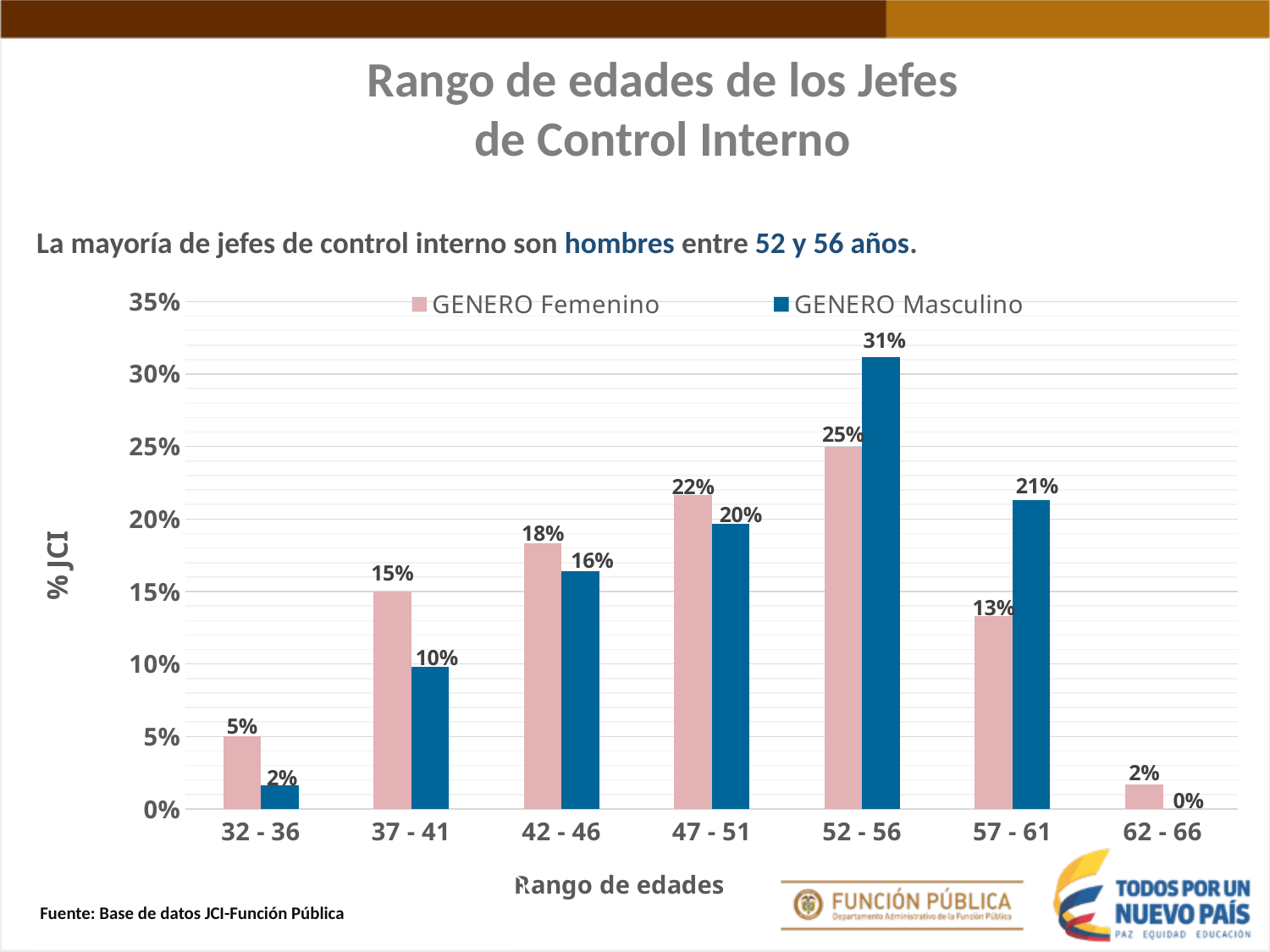
Which is larger in the 47 - 51 age range, GENERO Femenino or GENERO Masculino? GENERO Femenino What is the value for GENERO Masculino in the 62 - 66 age range? 0% What is the value for GENERO Femenino in the 37 - 41 age range? 15% Which age range has the highest value for GENERO Femenino? 52 - 56 How many age ranges are shown on the x axis? 7 What is the title of the chart on the slide? Rango de edades de los Jefes de Control Interno What is the difference between GENERO Masculino and GENERO Femenino in the 57 - 61 age range? 8% What is the label of the y axis? % JCI What kind of chart is shown on the slide? Bar chart How many series does the legend list? 2 Which age range has the lowest value for GENERO Masculino? 62 - 66 What is the value for GENERO Masculino in the 52 - 56 age range? 31%